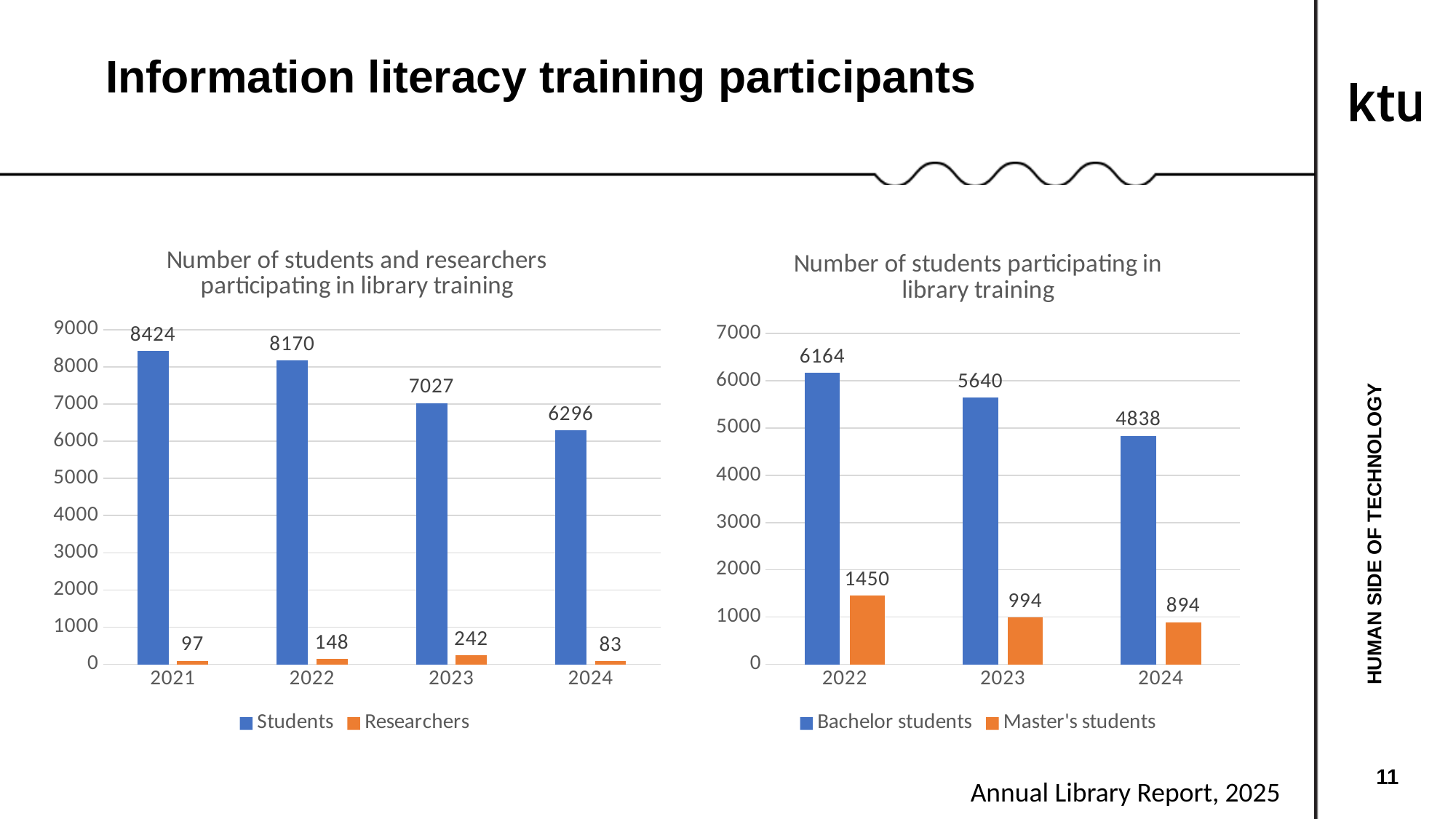
In the left chart 'Number of students and researchers participating in library training', how many years are shown on the x axis? 4 What kind of chart is the right chart 'Number of students participating in library training'? bar chart In the left chart 'Number of students and researchers participating in library training', what is the difference between the Students values for 2021 and 2024? 2128 In the left chart 'Number of students and researchers participating in library training', which year has the lowest value for Researchers? 2024 In the right chart 'Number of students participating in library training', which year has the highest value for Bachelor students? 2022 In the left chart 'Number of students and researchers participating in library training', what is the value for Students in 2021? 8424 In the right chart 'Number of students participating in library training', how many series does the legend list? 2 In the left chart 'Number of students and researchers participating in library training', do the Students values rise or fall from 2021 to 2024? fall In the right chart 'Number of students participating in library training', what is the difference between the Master's students values for 2023 and 2024? 100 In the left chart 'Number of students and researchers participating in library training', what is the value for Researchers in 2023? 242 In the right chart 'Number of students participating in library training', what is the value for Bachelor students in 2024? 4838 In the right chart 'Number of students participating in library training', what is the value for Master's students in 2022? 1450